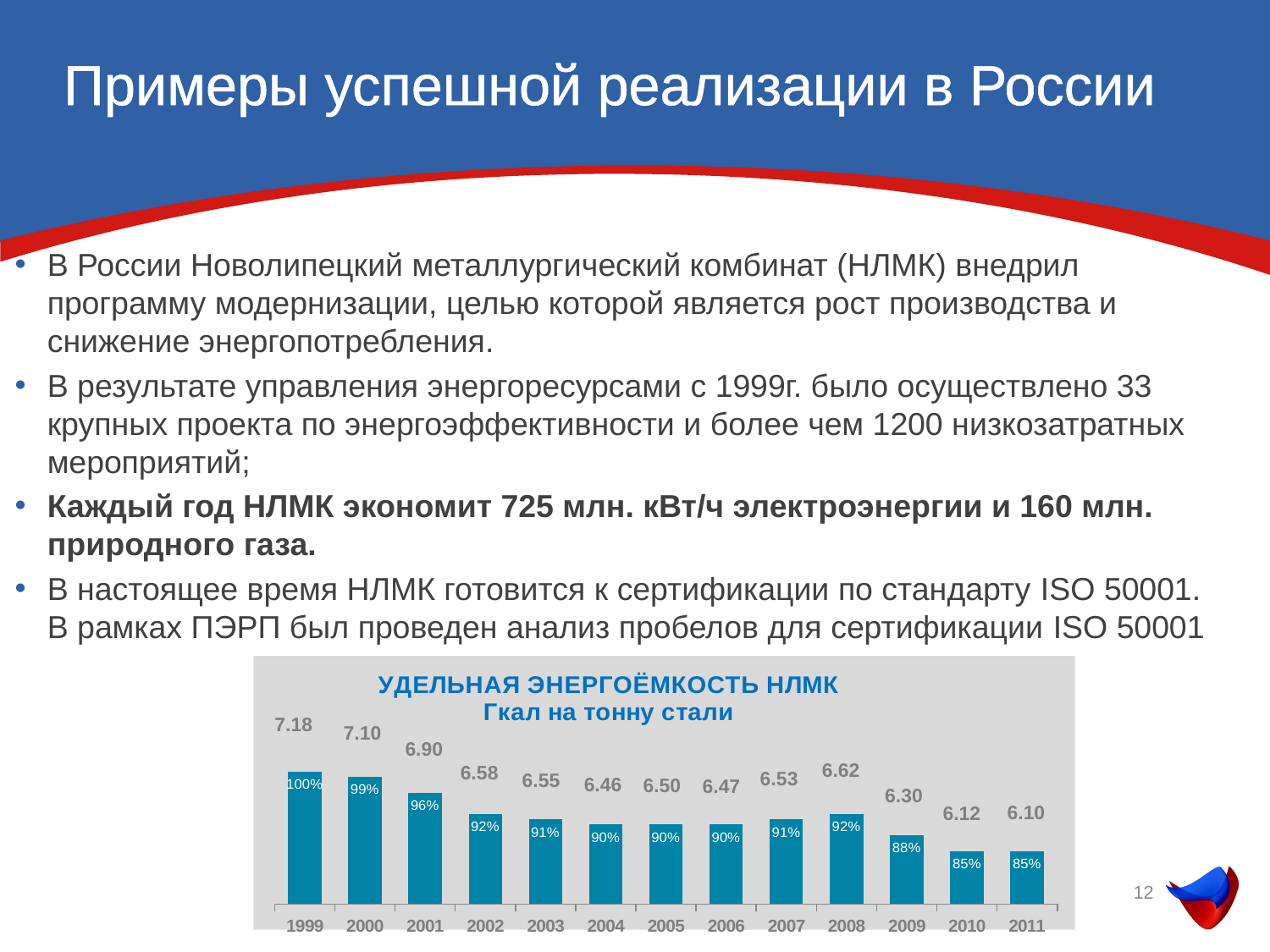
Which year has the highest value in the chart? 1999 Do the values generally rise or fall from 1999 to 2011? Fall What kind of chart is shown on the slide? Bar chart How many years are shown on the x axis of the chart? 13 Which year has the lowest value in the chart? 2011 What percentage label is printed on the bar for 2002? 92% What is the difference between the values for 1999 and 2011? 1.08 What is the value shown above the bar for 2009 in the chart? 6.30 What is the value shown above the bar for 1999 in the chart 'УДЕЛЬНАЯ ЭНЕРГОЁМКОСТЬ НЛМК'? 7.18 What is the difference between the values for 2008 and 2009? 0.32 What percentage label is printed on the bar for 2011? 85% Which year has the larger value, 2001 or 2010? 2001